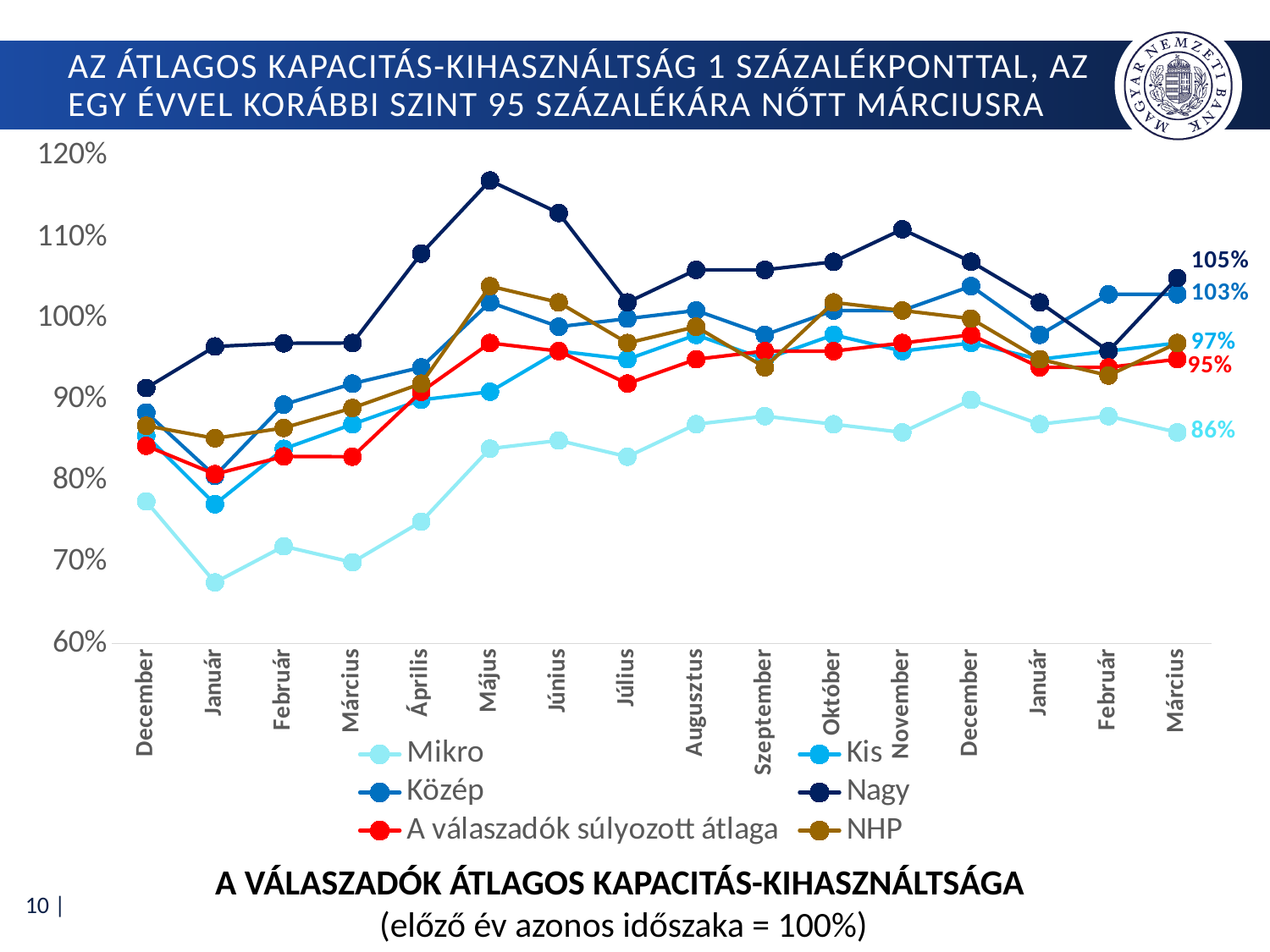
How many months are shown on the x axis? 16 Which series has the highest value in Május? Nagy What type of chart is shown on the slide? line chart What is the value for A válaszadók súlyozott átlaga in the final Március? 95% What is the value for Mikro in the final Március? 86% What is the value for Nagy in the final Március? 105% What is the value for Közép in the final Március? 103% Is the value for Mikro in the first Január greater or less than 70%? less What is the difference between the Nagy and Mikro values in the final Március? 19 percentage points How many series does the legend list? 6 Is the value for Nagy in Május greater or less than 110%? greater Which series has the lowest value in Január (the first Január)? Mikro